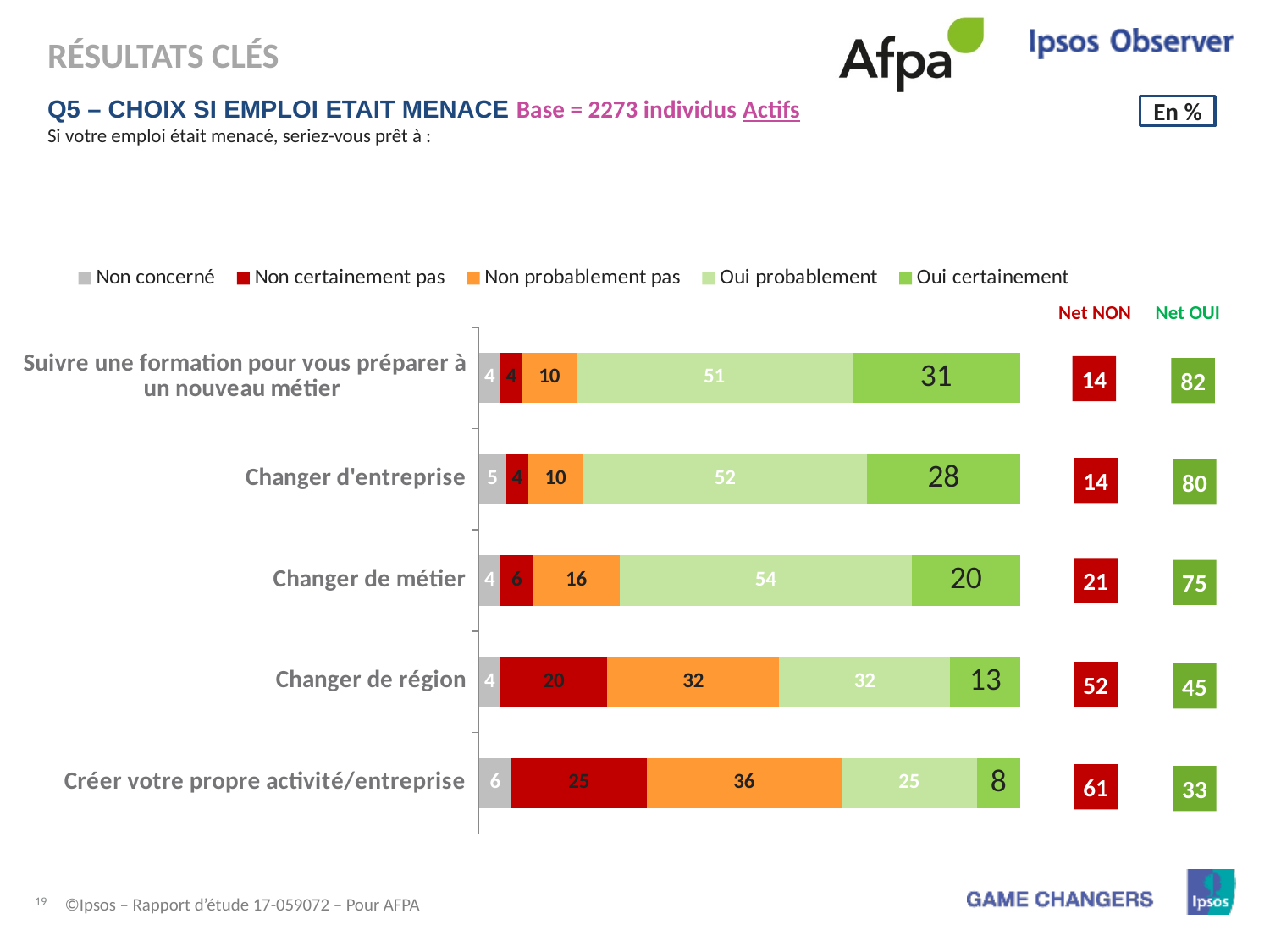
What is the value for "Non probablement pas" for "Créer votre propre activité/entreprise"? 36 What is the value for "Oui probablement" for "Changer de métier"? 54 What is the value for "Non certainement pas" for "Changer de région"? 20 What is the difference between the "Oui certainement" values for "Changer d'entreprise" and "Changer de région"? 15 How many categories are shown in the chart? 5 How many series does the legend list? 5 What is the total of the stacked bar for "Changer d'entreprise"? 99 Which is larger: the "Non probablement pas" value for "Changer de métier" or for "Changer de région"? Changer de région Which category has the highest value for "Oui certainement"? Suivre une formation pour vous préparer à un nouveau métier What is the value for "Oui certainement" for "Suivre une formation pour vous préparer à un nouveau métier"? 31 What kind of chart is shown on the slide? Stacked bar chart Which category has the lowest value for "Oui certainement"? Créer votre propre activité/entreprise